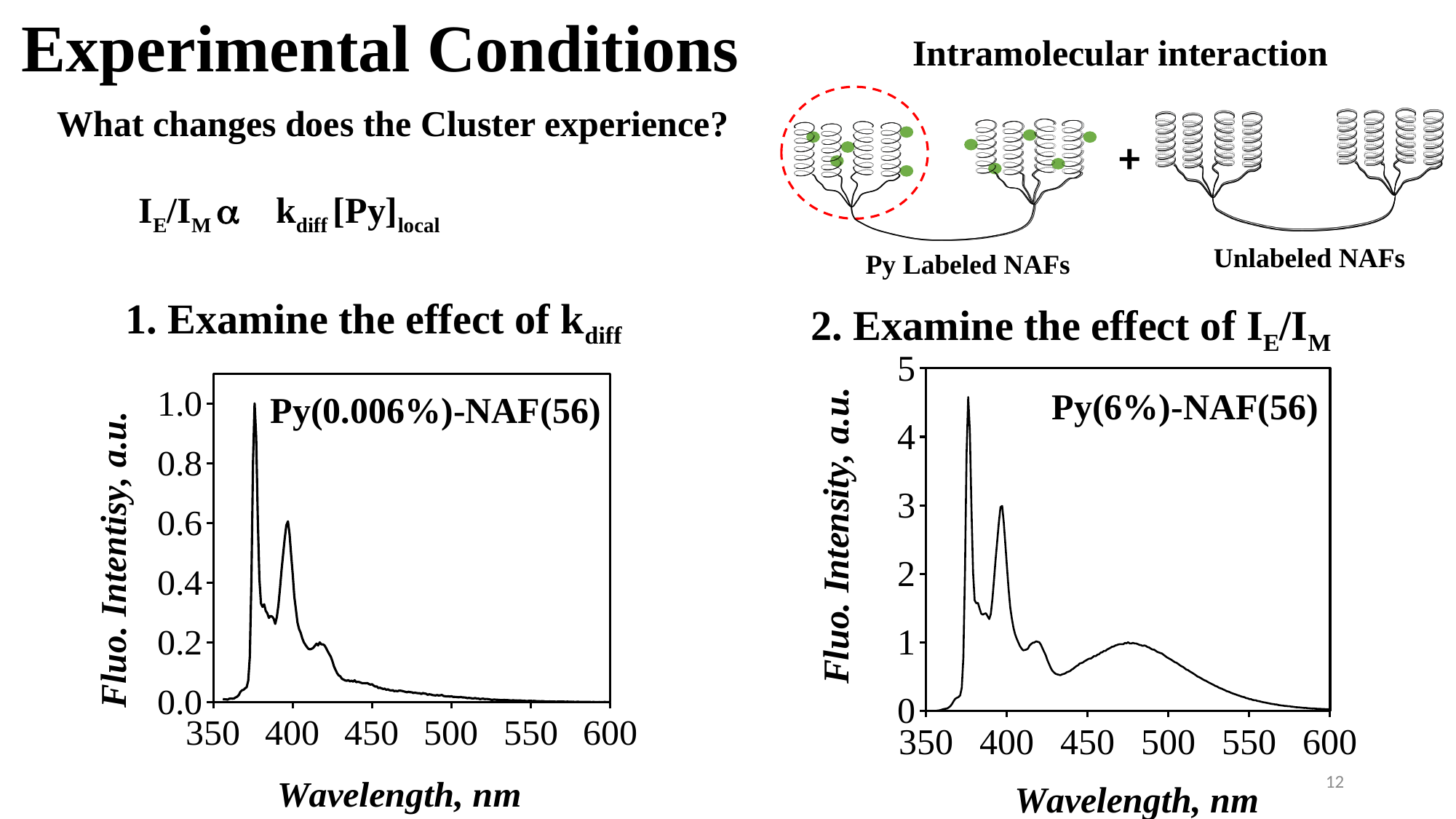
In the right chart (Py(6%)-NAF(56)), does the intensity rise or fall as wavelength increases from 500 nm to 600 nm? fall In the right chart (Py(6%)-NAF(56)), is the intensity at 550 nm greater or less than 1? less In the left chart (Py(0.006%)-NAF(56)), does the intensity rise or fall as wavelength increases from 450 nm to 600 nm? fall What kind of chart is the left chart labeled Py(0.006%)-NAF(56)? line chart In the left chart (Py(0.006%)-NAF(56)), is the peak intensity near 375 nm greater or less than 0.8? greater What kind of chart is the right chart labeled Py(6%)-NAF(56)? line chart In the right chart (Py(6%)-NAF(56)), which is larger: the intensity at 375 nm or the intensity at 475 nm? 375 nm In the left chart (Py(0.006%)-NAF(56)), what is the x-axis label? Wavelength, nm In the right chart (Py(6%)-NAF(56)), is the peak intensity near 375 nm greater or less than 4? greater In the right chart (Py(6%)-NAF(56)), what is the y-axis label? Fluo. Intensity, a.u.